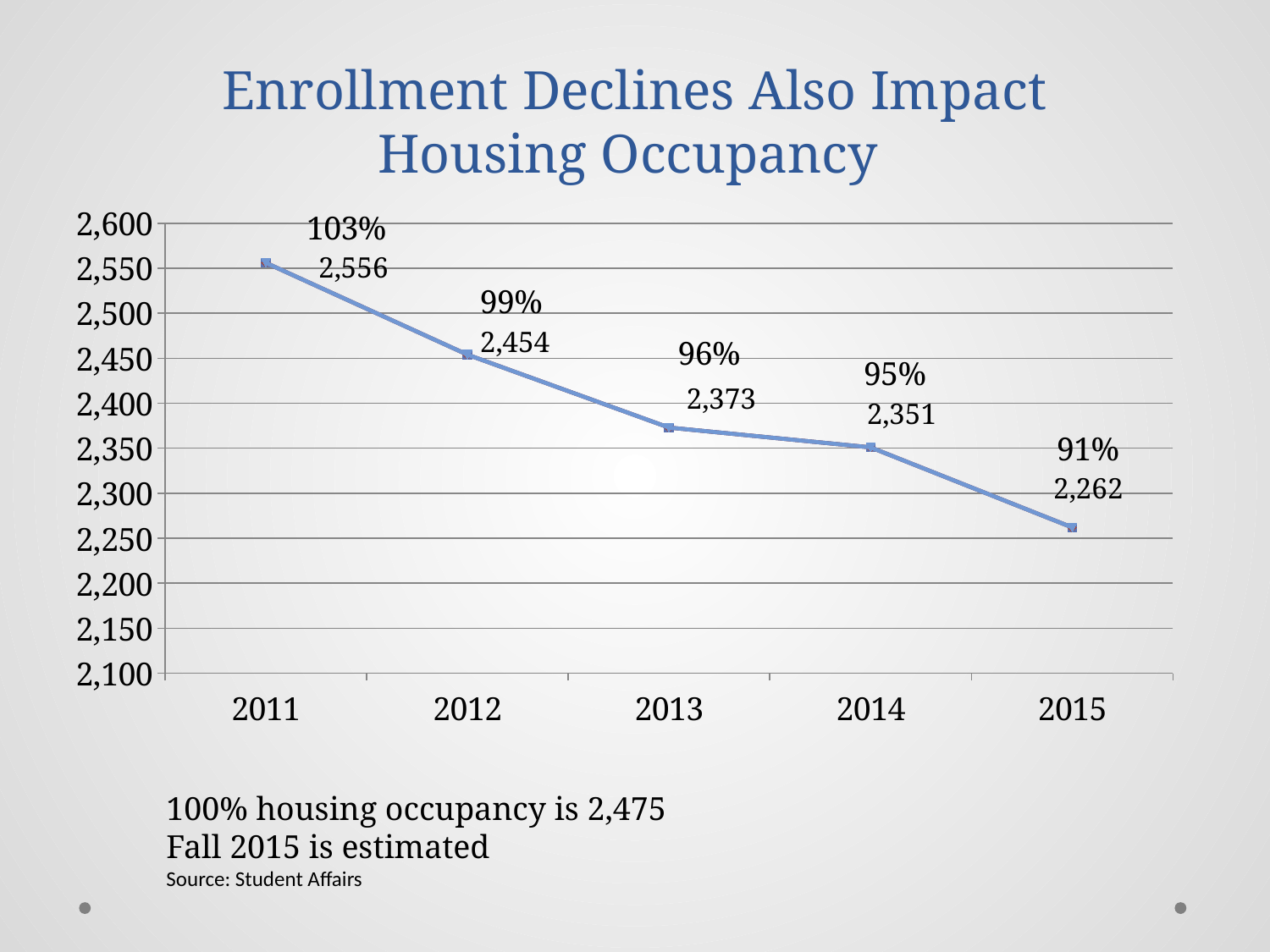
How many years are plotted on the chart? 5 Which year has a larger value, 2012 or 2014? 2012 What kind of chart is shown on the slide? Line chart What occupancy percentage is shown for 2015? 91% What is the difference between the 2013 value and the 2014 value? 22 What is the housing occupancy value for 2013? 2,373 What is the difference between the 2011 value and the 2015 value? 294 What occupancy percentage is shown for 2012? 99% What is the housing occupancy value for 2011? 2,556 Which year has the lowest housing occupancy value? 2015 Which year has the highest housing occupancy value? 2011 Do the values rise or fall from 2011 to 2015? Fall